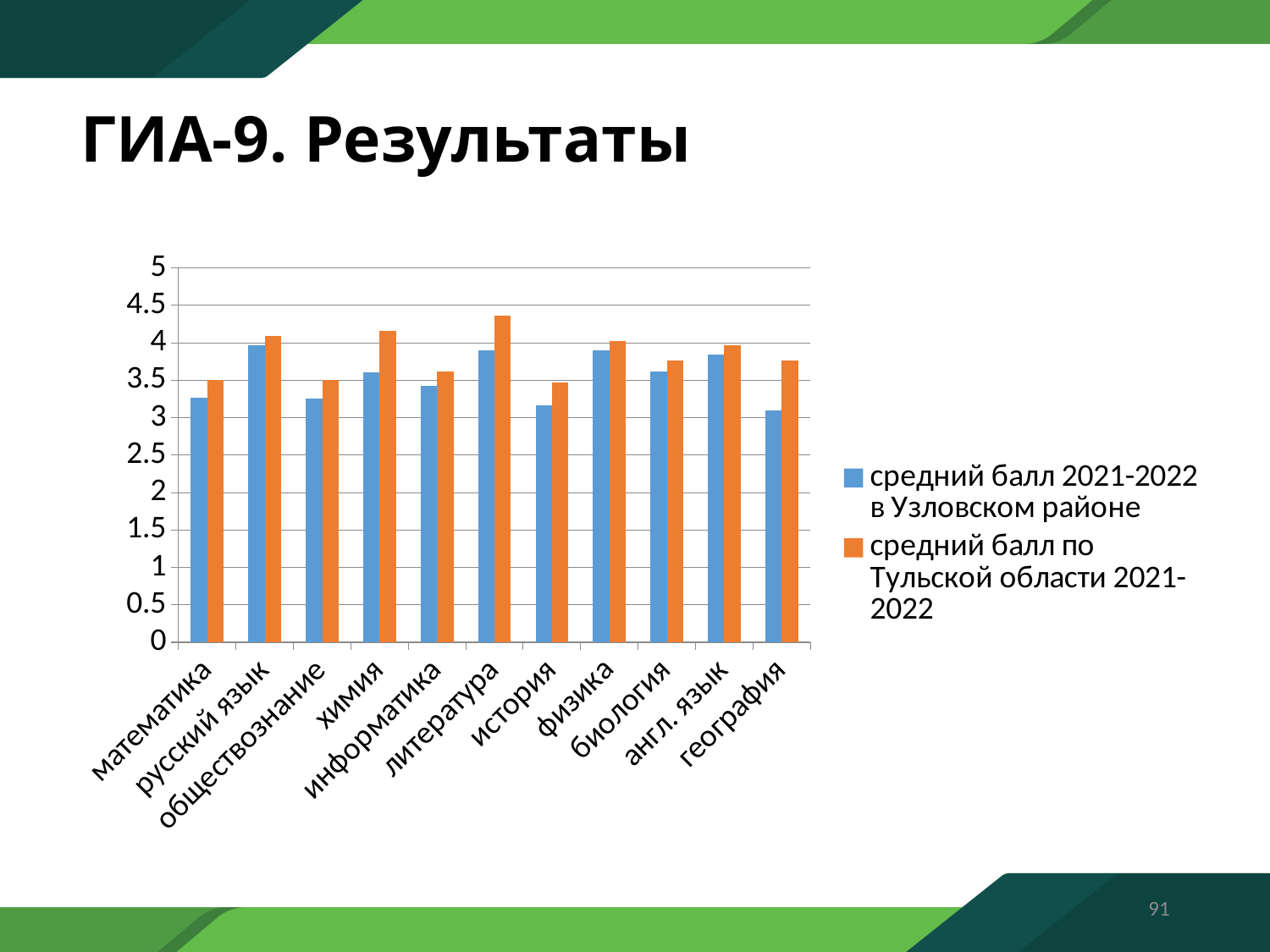
Is the value for география in the series 'средний балл 2021-2022 в Узловском районе' greater or less than 3.5? less Which subject has the highest value for the series 'средний балл по Тульской области 2021-2022'? литература Which colour represents the series 'средний балл по Тульской области 2021-2022' in the chart? orange How many series does the chart legend list? 2 Is the value for литература in the series 'средний балл по Тульской области 2021-2022' greater or less than 4? greater In the series 'средний балл 2021-2022 в Узловском районе', which is larger: the value for русский язык or the value for математика? русский язык Is the value for математика in the series 'средний балл 2021-2022 в Узловском районе' greater or less than 3.5? less What is the title of the slide containing the chart? ГИА-9. Результаты What kind of chart is shown on the slide? bar chart For химия, which series has the larger value: 'средний балл 2021-2022 в Узловском районе' or 'средний балл по Тульской области 2021-2022'? средний балл по Тульской области 2021-2022 How many subject categories are shown on the x axis of the chart? 11